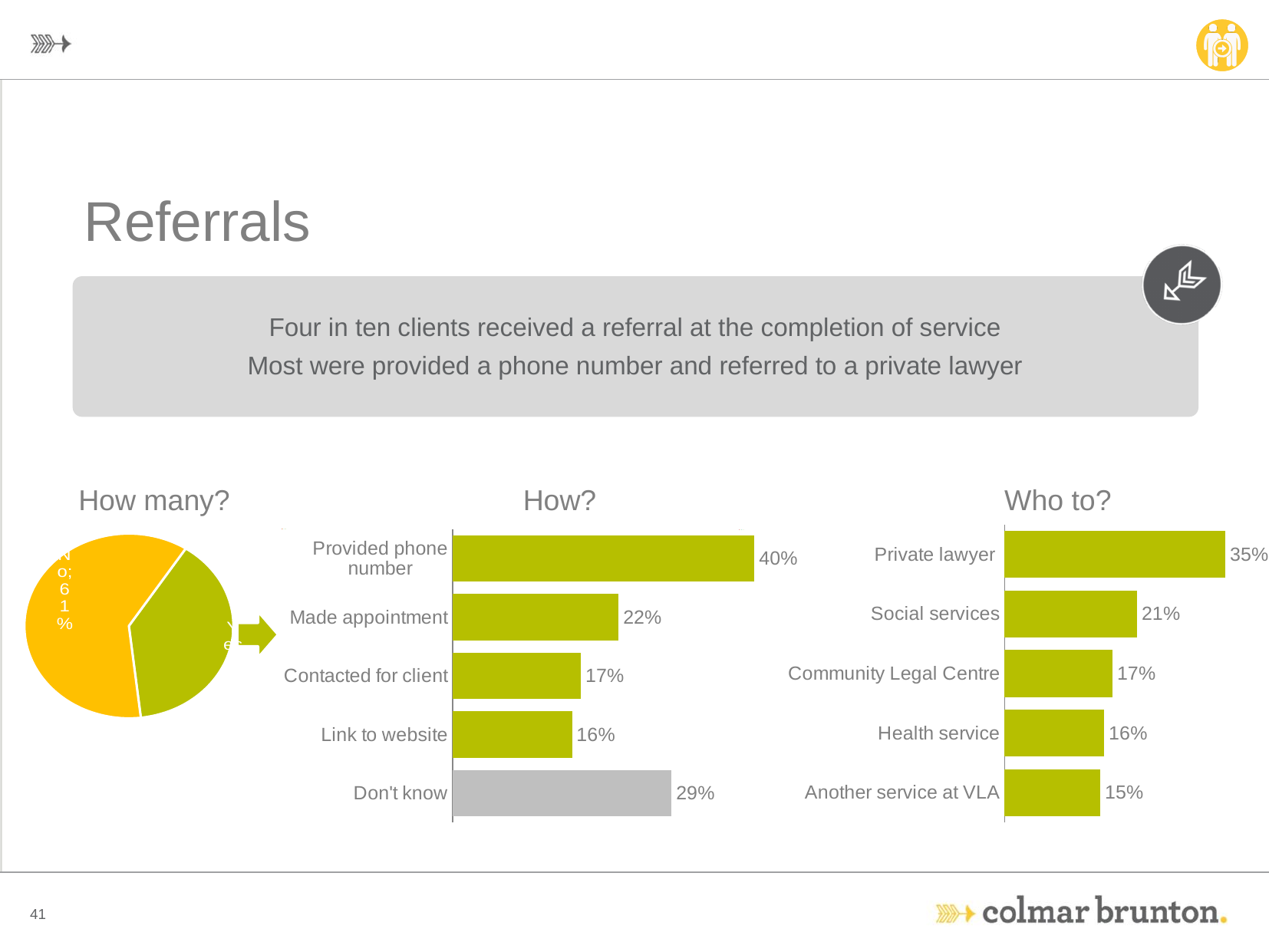
In the "How?" chart, what is the difference between Provided phone number and Made appointment? 18% In the "How?" chart, which category has the lowest value? Link to website In the "Who to?" chart, what is the value for Another service at VLA? 15% In the "Who to?" chart, which category has the highest value? Private lawyer In the "Who to?" chart, what is the value for Social services? 21% How many categories are shown in the "Who to?" chart? 5 In the "Who to?" chart, which is larger: Community Legal Centre or Health service? Community Legal Centre In the "How?" chart, what is the value for Don't know? 29% What kind of chart is the "How?" chart? Bar chart In the "How many?" pie chart, what share of the pie is the No slice? 61% What kind of chart is the "How many?" chart? Pie chart In the "How?" chart, what is the value for Provided phone number? 40%